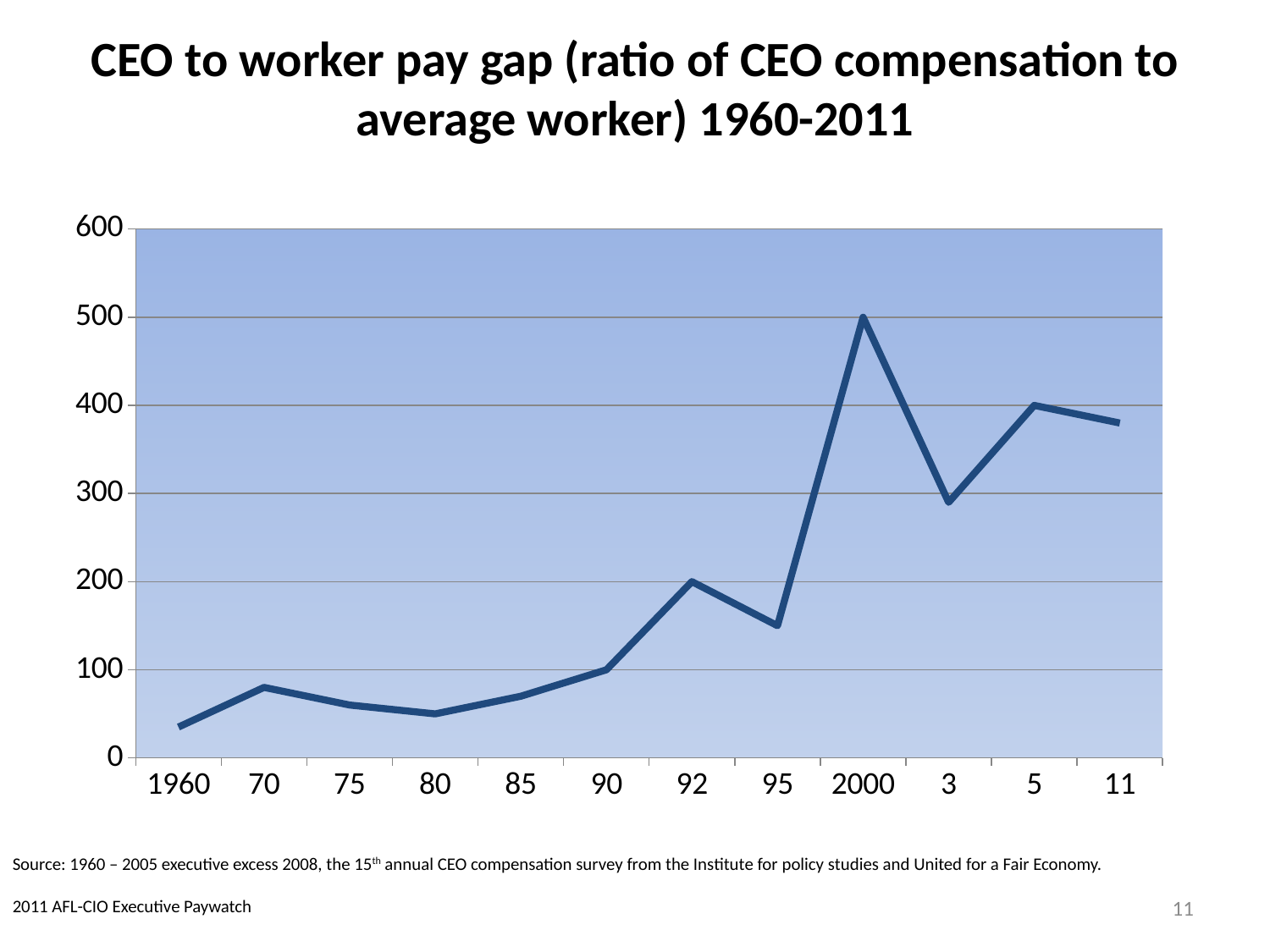
What is the CEO to worker pay ratio in 2000? 500 What is the CEO to worker pay ratio in 92? 200 What kind of chart is shown on the slide? line chart Is the value for 95 greater or less than 200? less Which year has the lowest CEO to worker pay ratio? 1960 What is the difference between the ratio in 2000 and the ratio in 92? 300 Is the value for 11 greater or less than 400? less Which year has the highest CEO to worker pay ratio? 2000 How many points (years) are plotted along the x axis? 12 Does the ratio generally rise or fall from 1960 to 2011? rise Is the value for 3 greater or less than 300? less Which is larger, the ratio in 2000 or the ratio in 5? 2000